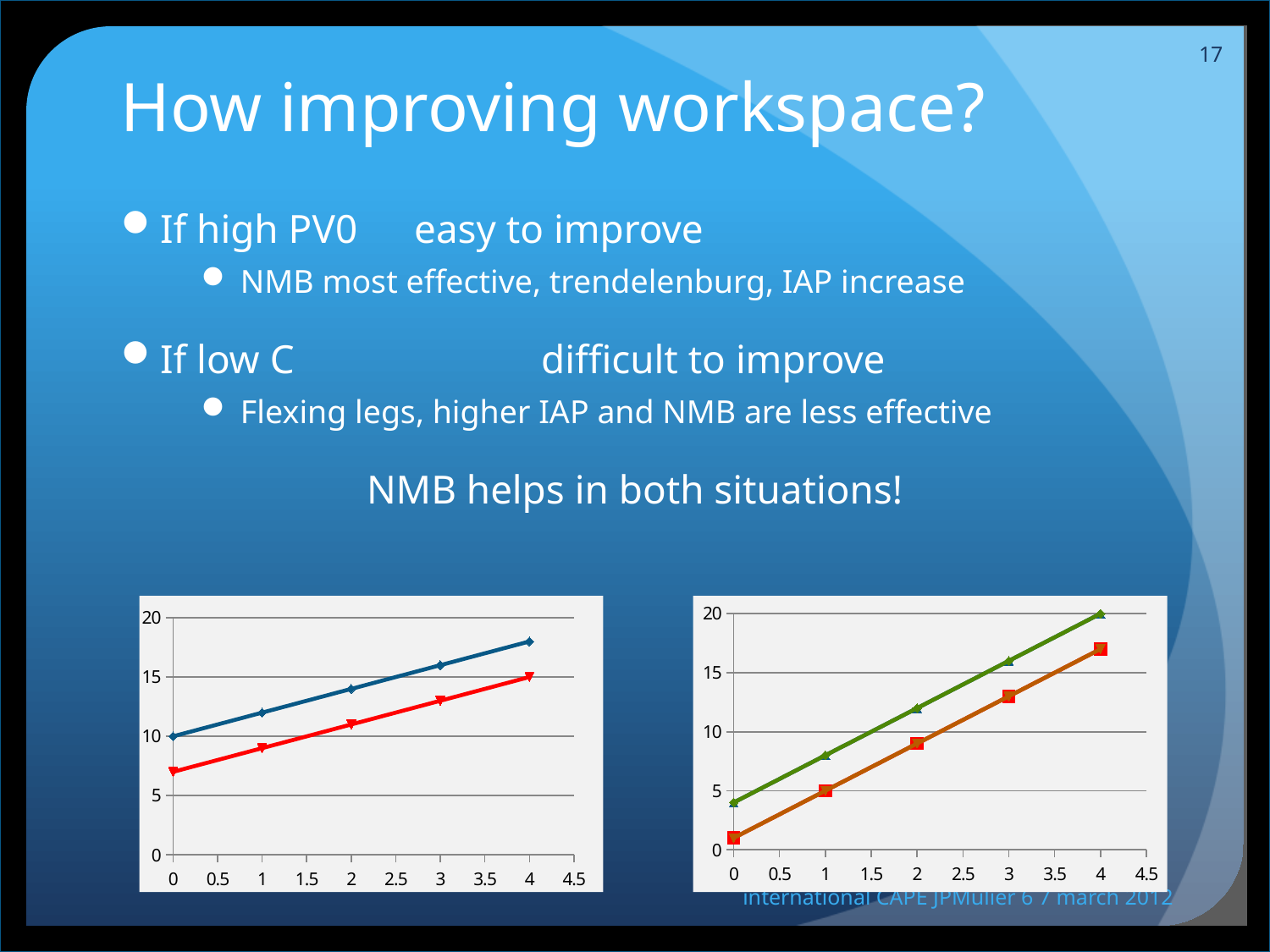
In the right chart, do the values of the green line rise or fall as x increases? rise In the left chart, what is the value of the blue line at x = 0? 10 What kind of chart is the chart on the left of the slide? line chart In the left chart, what is the value of the red line at x = 4? 15 In the left chart, is the value of the blue line at x = 4 greater or less than 15? greater How many lines are plotted in the right chart? 2 In the right chart, is the value of the orange line at x = 4 greater or less than 15? greater In the left chart, which line has the higher value at x = 2, the blue line or the red line? the blue line In the left chart, how many data points are plotted on the red line? 5 In the right chart, what is the value of the green line at x = 4? 20 In the right chart, is the value of the green line at x = 0 greater or less than 5? less In the right chart, what is the value of the orange line at x = 1? 5